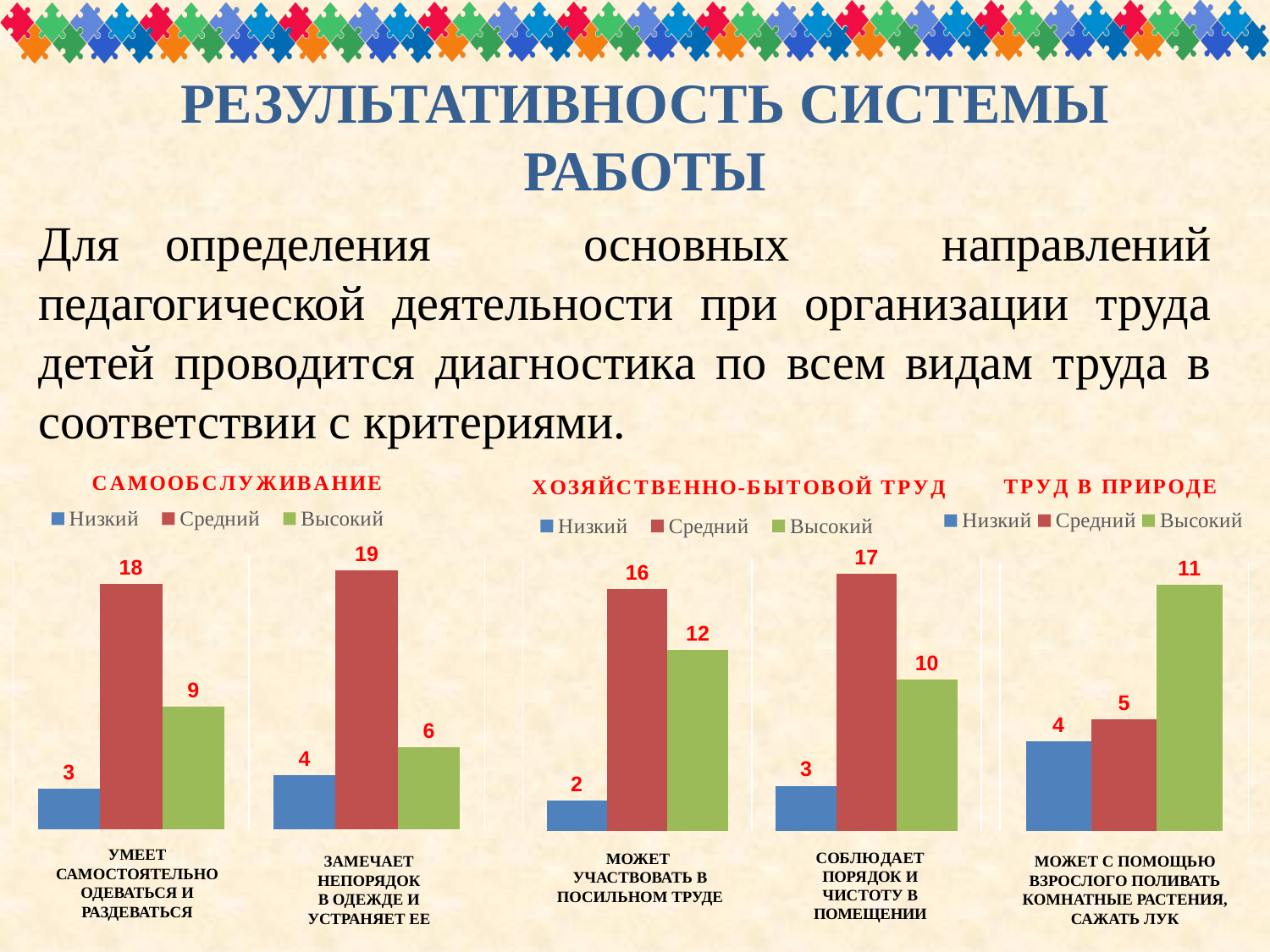
In the chart titled "ХОЗЯЙСТВЕННО-БЫТОВОЙ ТРУД", which series has the lowest value for "Соблюдает порядок и чистоту в помещении"? Низкий In the chart titled "САМООБСЛУЖИВАНИЕ", what is the difference between "Средний" and "Высокий" for "Умеет самостоятельно одеваться и раздеваться"? 9 In the chart titled "САМООБСЛУЖИВАНИЕ", what is the value of "Средний" for "Умеет самостоятельно одеваться и раздеваться"? 18 In the chart titled "САМООБСЛУЖИВАНИЕ", what is the value of "Высокий" for "Замечает непорядок в одежде и устраняет ее"? 6 What type of chart is the chart titled "САМООБСЛУЖИВАНИЕ"? Bar chart In the chart titled "ХОЗЯЙСТВЕННО-БЫТОВОЙ ТРУД", what is the value of "Высокий" for "Может участвовать в посильном труде"? 12 How many series does the legend of the chart titled "ТРУД В ПРИРОДЕ" list? 3 In the chart titled "ТРУД В ПРИРОДЕ", what is the value of "Высокий"? 11 In the chart titled "САМООБСЛУЖИВАНИЕ", which series has the highest value for "Замечает непорядок в одежде и устраняет ее"? Средний In the chart titled "ХОЗЯЙСТВЕННО-БЫТОВОЙ ТРУД", is "Средний" larger for "Может участвовать в посильном труде" or for "Соблюдает порядок и чистоту в помещении"? Соблюдает порядок и чистоту в помещении In the chart titled "ТРУД В ПРИРОДЕ", what is the difference between "Высокий" and "Низкий"? 7 In the chart titled "ХОЗЯЙСТВЕННО-БЫТОВОЙ ТРУД", how many categories are shown on the x axis? 2